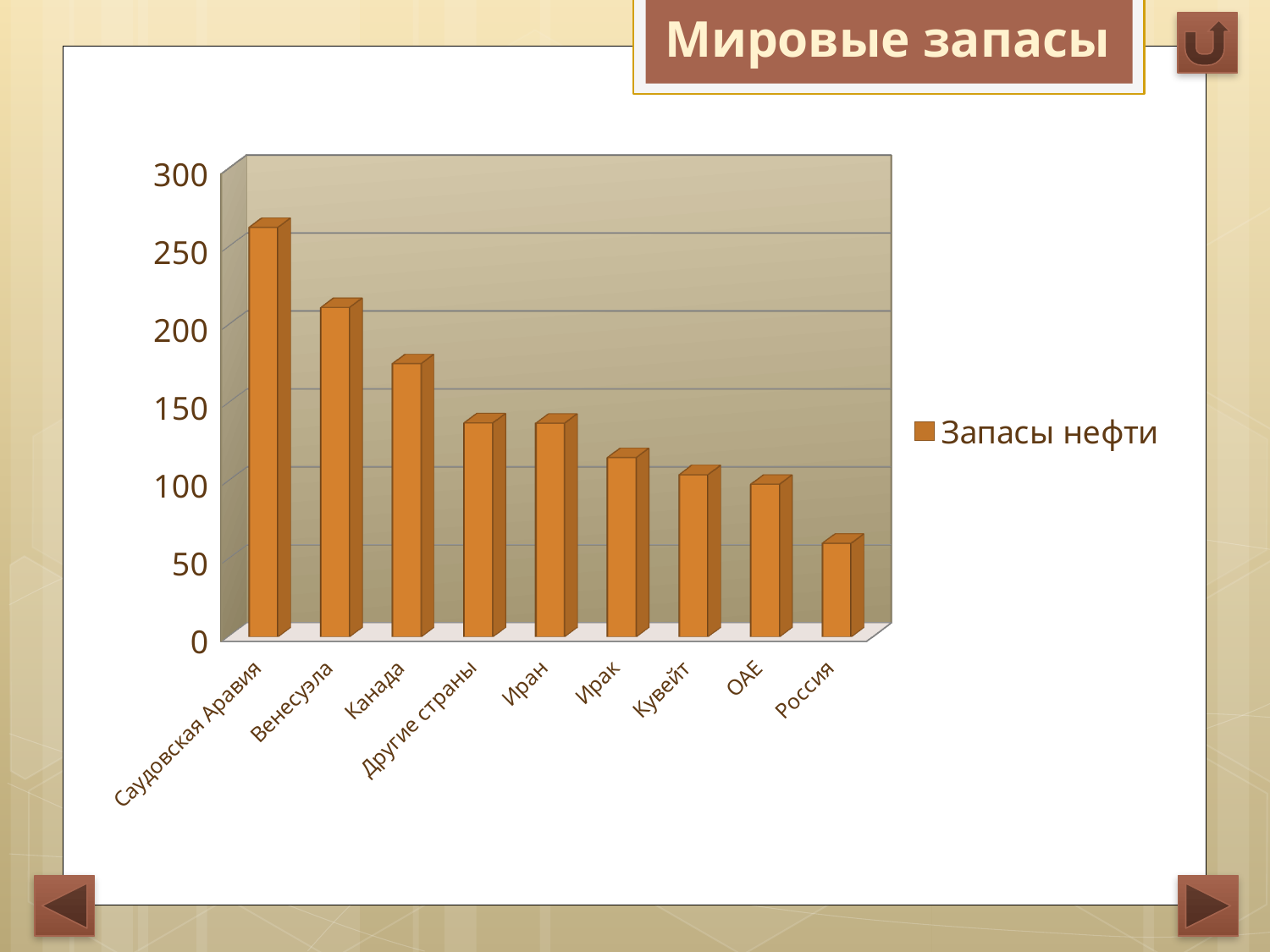
Which category has the lowest value? Россия How many series does the legend list? 1 Is the value for Саудовская Аравия greater or less than 250? greater Which category has the highest value? Саудовская Аравия Is the value for Иран greater or less than 150? less Do the values rise or fall from left to right along the x axis? fall Which is larger, the value for Венесуэла or the value for Канада? Венесуэла How many categories are shown on the x axis? 9 What kind of chart is shown on the slide? bar chart Is the value for Россия greater or less than 100? less What is the name of the series shown in the legend? Запасы нефти